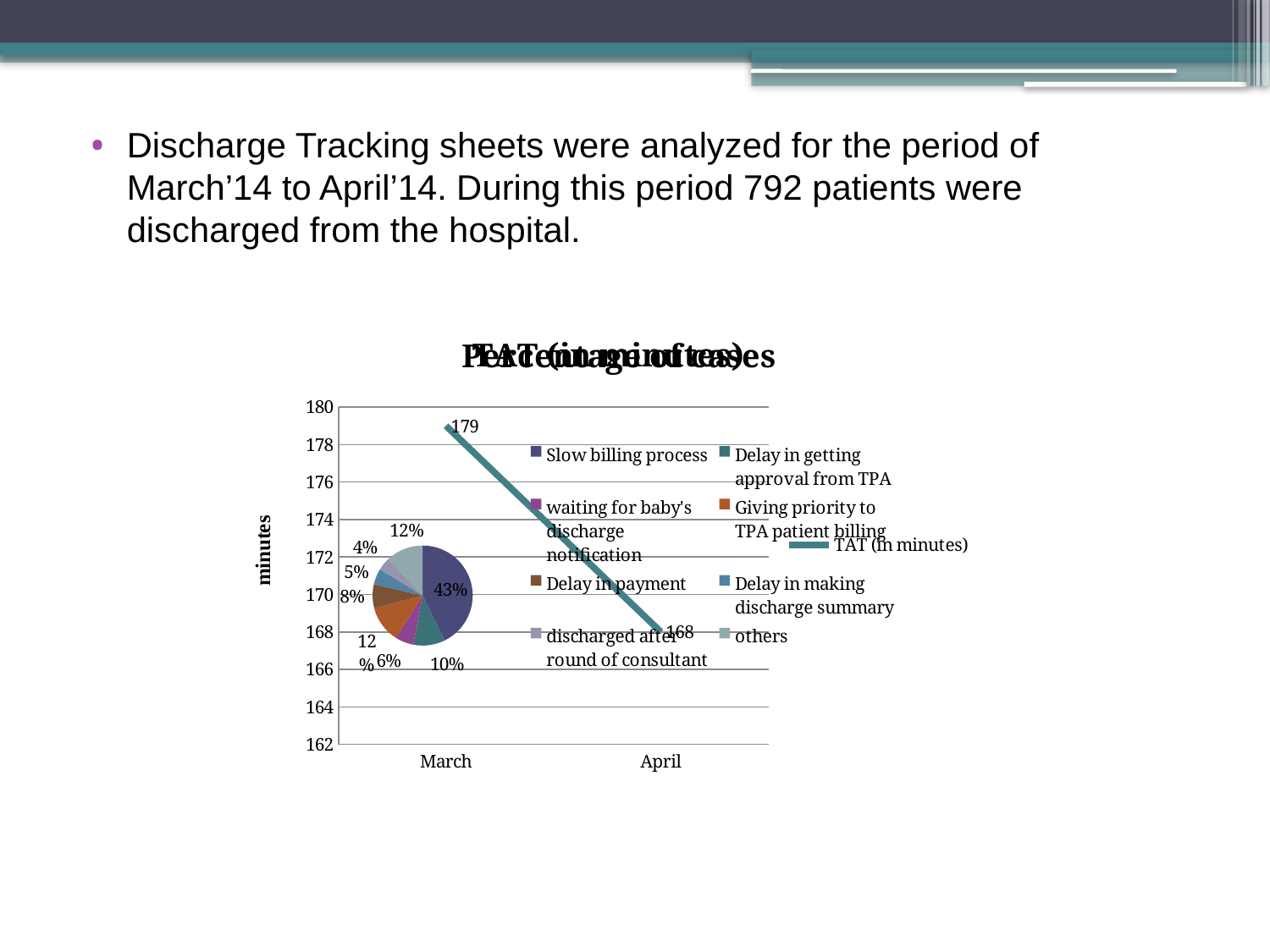
How many categories does the pie chart's legend list? 8 On the line chart, what is the TAT (in minutes) value for April? 168 On the line chart, which month has the higher TAT, March or April? March On the line chart, what is the y-axis label? minutes On the pie chart, which category has the largest share? Slow billing process On the line chart, how many months are plotted on the x axis? 2 On the line chart, does the TAT rise or fall from March to April? fall What type of chart shows the percentage breakdown of cases? pie chart On the pie chart, what share is labelled for the 'Slow billing process' slice? 43% On the line chart, by how many minutes does TAT differ between March and April? 11 On the line chart, what is the TAT (in minutes) value for March? 179 On the pie chart, what is the largest slice's share? 43%